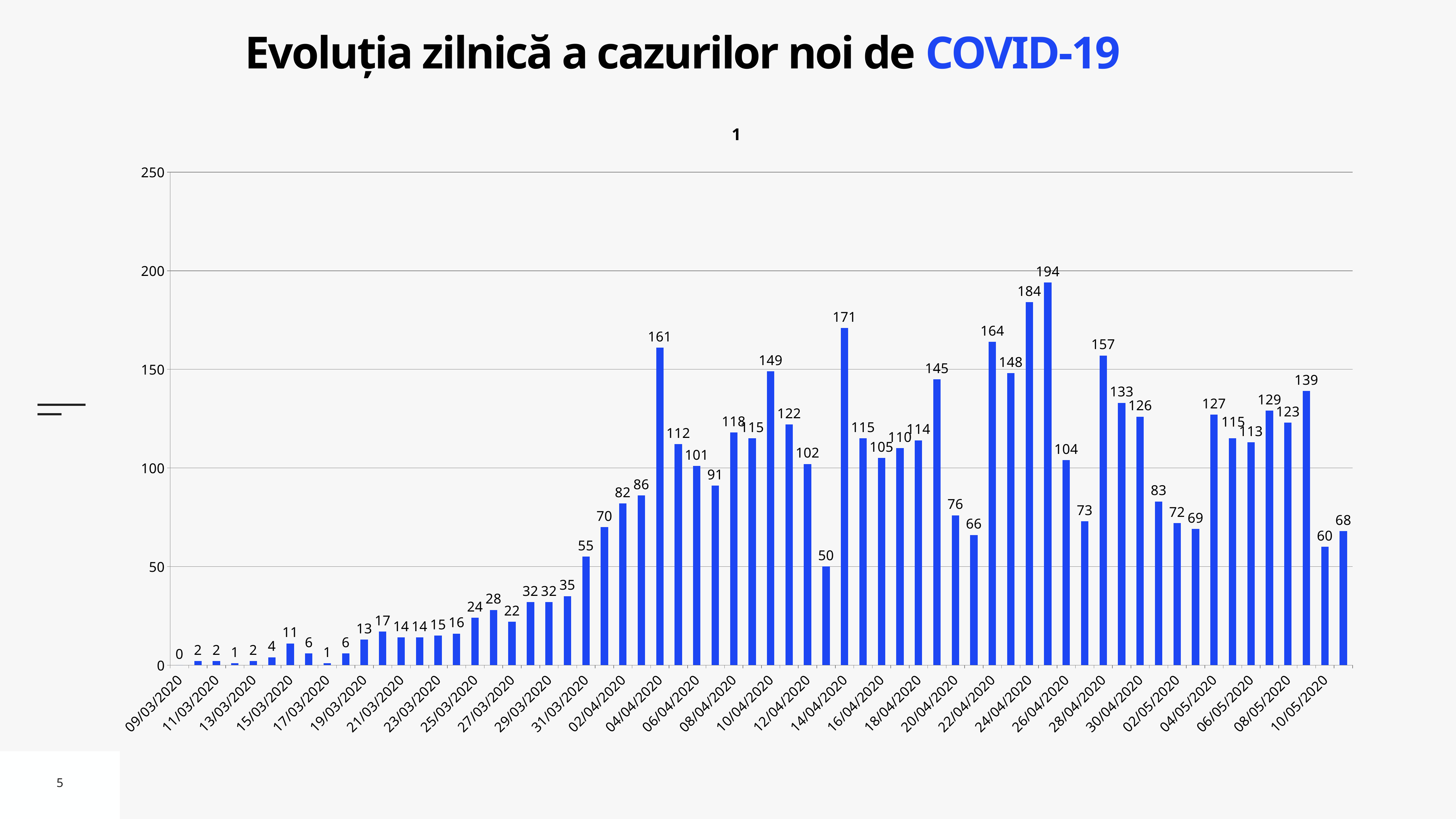
What is the value for 09/03/2020? 0 Which date has the lowest value in the chart? 09/03/2020 What is the highest value shown in the chart? 194 What is the title of the slide? Evoluția zilnică a cazurilor noi de COVID-19 What is the value for 24/04/2020? 184 What is the difference between the values for 14/04/2020 and 04/04/2020? 10 Which is larger, the value for 22/04/2020 or the value for 28/04/2020? 22/04/2020 What is the value for 10/04/2020? 149 What is the value for 04/04/2020? 161 What kind of chart is shown on the slide? bar chart Do the values generally rise or fall from 09/03/2020 to 04/04/2020? rise What is the value for 14/04/2020? 171